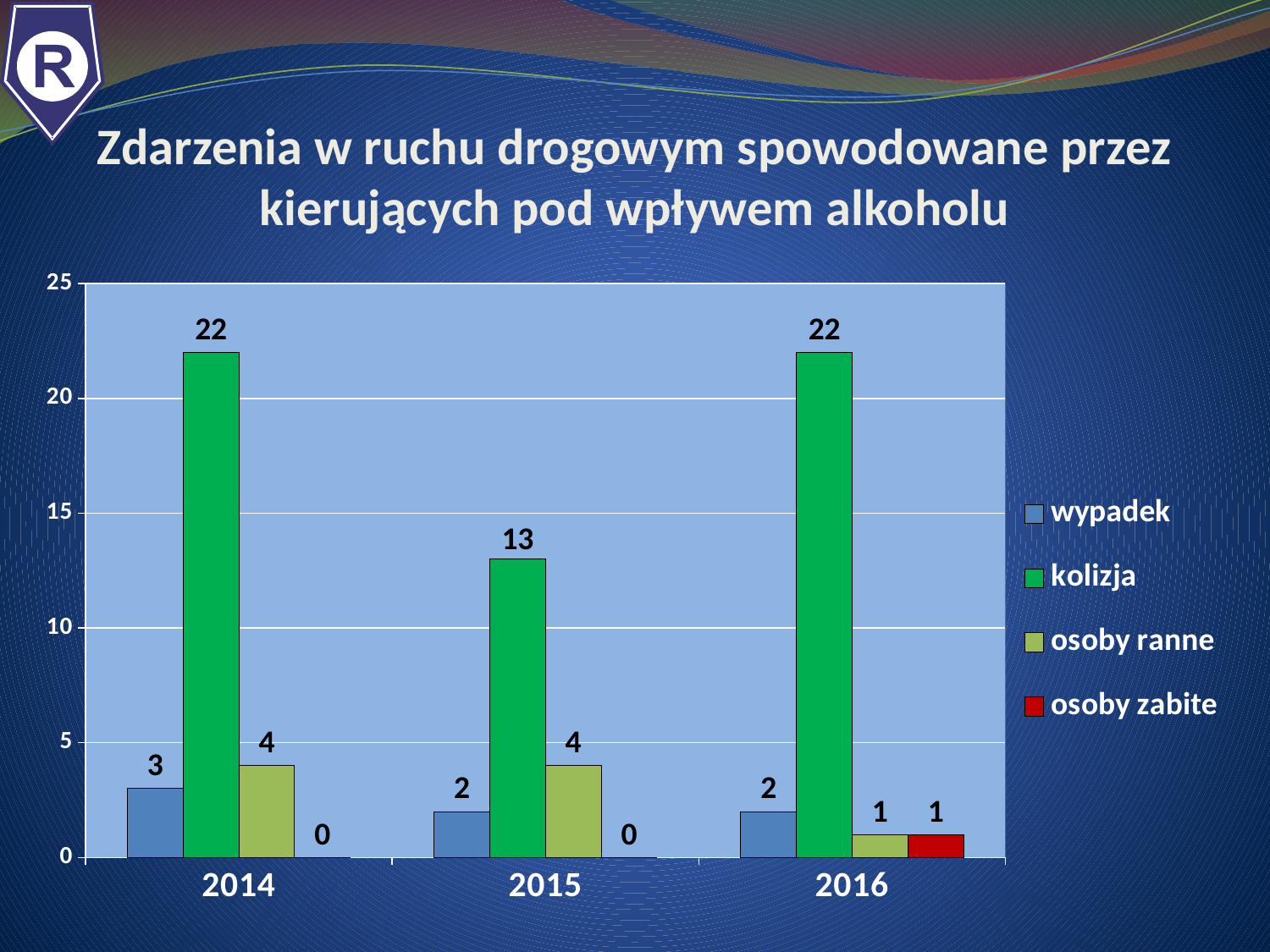
What is the value for wypadek in 2014? 3 How many series does the legend list? 4 How many years are shown on the x axis? 3 Which series is shown in red in the legend? osoby zabite What is the difference between the kolizja values for 2014 and 2015? 9 What is the value for osoby zabite in 2016? 1 What is the value for osoby ranne in 2016? 1 What kind of chart is shown on the slide? bar chart What is the value for kolizja in 2015? 13 In which year is the wypadek value highest? 2014 In which year is the kolizja value lowest? 2015 Which is larger, osoby ranne in 2015 or osoby ranne in 2016? osoby ranne in 2015